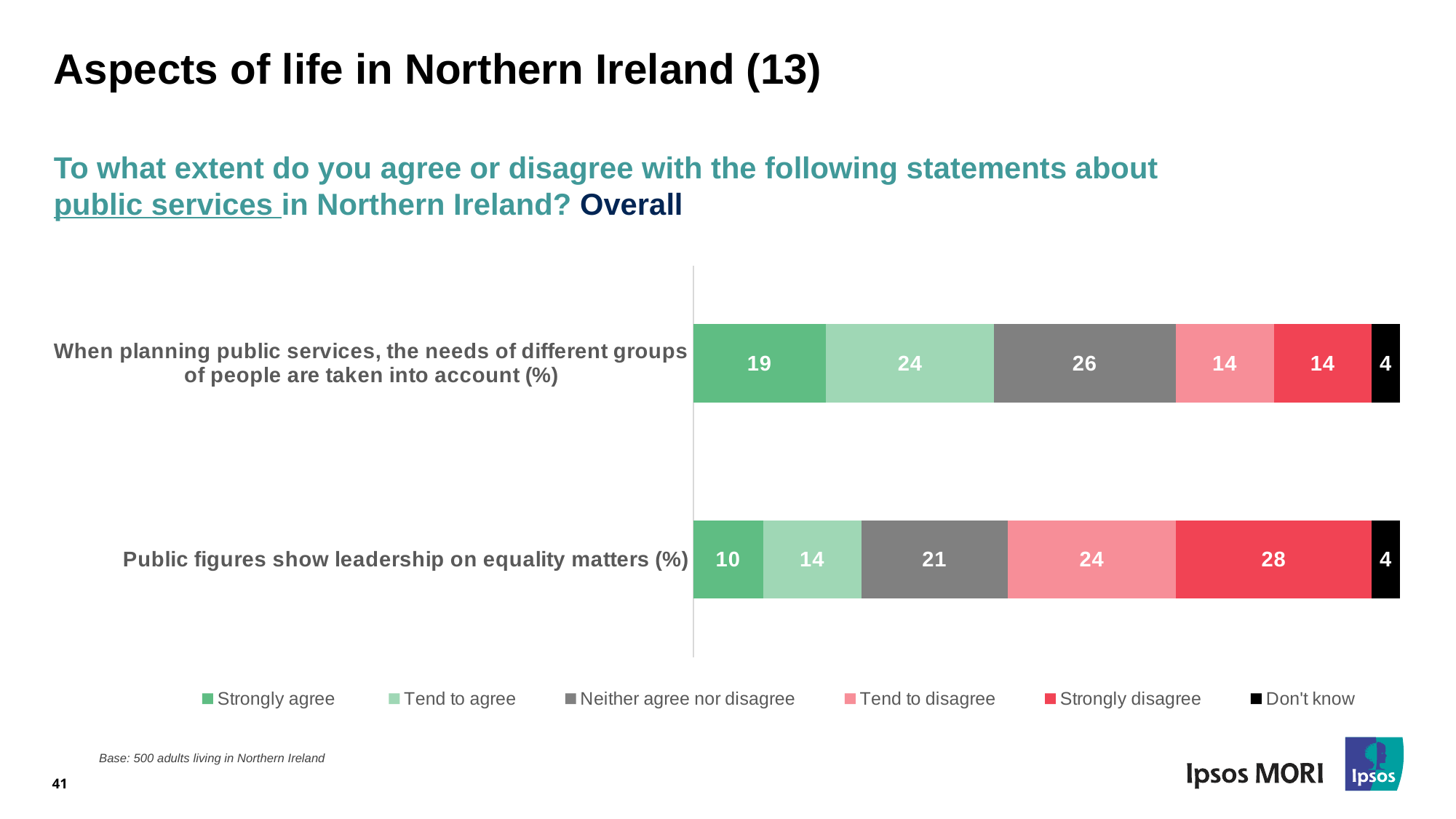
How many statements are shown in the chart? 2 What percentage strongly agree that when planning public services, the needs of different groups of people are taken into account? 19 What percentage tend to agree that when planning public services, the needs of different groups of people are taken into account? 24 What colour represents 'Don't know' in the chart? Black Which response category has the largest share for the statement about the needs of different groups being taken into account when planning public services? Neither agree nor disagree Which statement has a higher 'Tend to disagree' percentage? Public figures show leadership on equality matters What is the difference between the 'Strongly disagree' percentages for the two statements? 14 What percentage neither agree nor disagree that public figures show leadership on equality matters? 21 What kind of chart is shown on the slide? Stacked bar chart Which response category has the smallest share for the statement that public figures show leadership on equality matters? Don't know What percentage strongly disagree that public figures show leadership on equality matters? 28 How many series does the legend list? 6